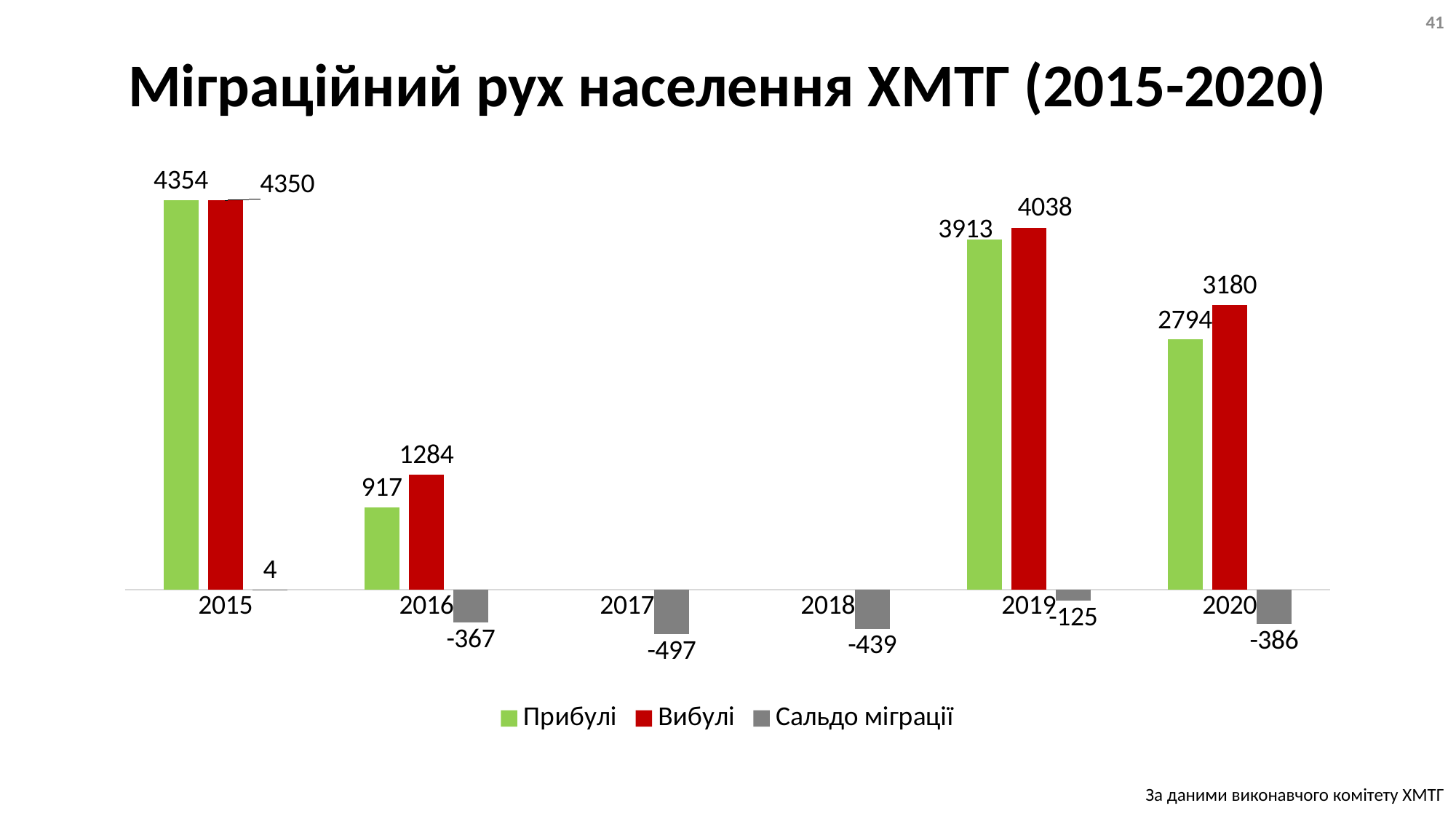
How many series does the legend list? 3 In which year is the Сальдо міграції value lowest? 2017 What is the value of Прибулі for 2015? 4354 In which year is the Вибулі value highest? 2015 Which is larger in 2016, Прибулі or Вибулі? Вибулі What is the value of Сальдо міграції for 2017? -497 How many years are shown on the x axis? 6 What is the difference between Вибулі and Прибулі in 2019? 125 Which colour represents the Сальдо міграції series? Gray What kind of chart is shown on the slide? Bar chart What is the value of Вибулі for 2020? 3180 What is the value of Сальдо міграції for 2015? 4